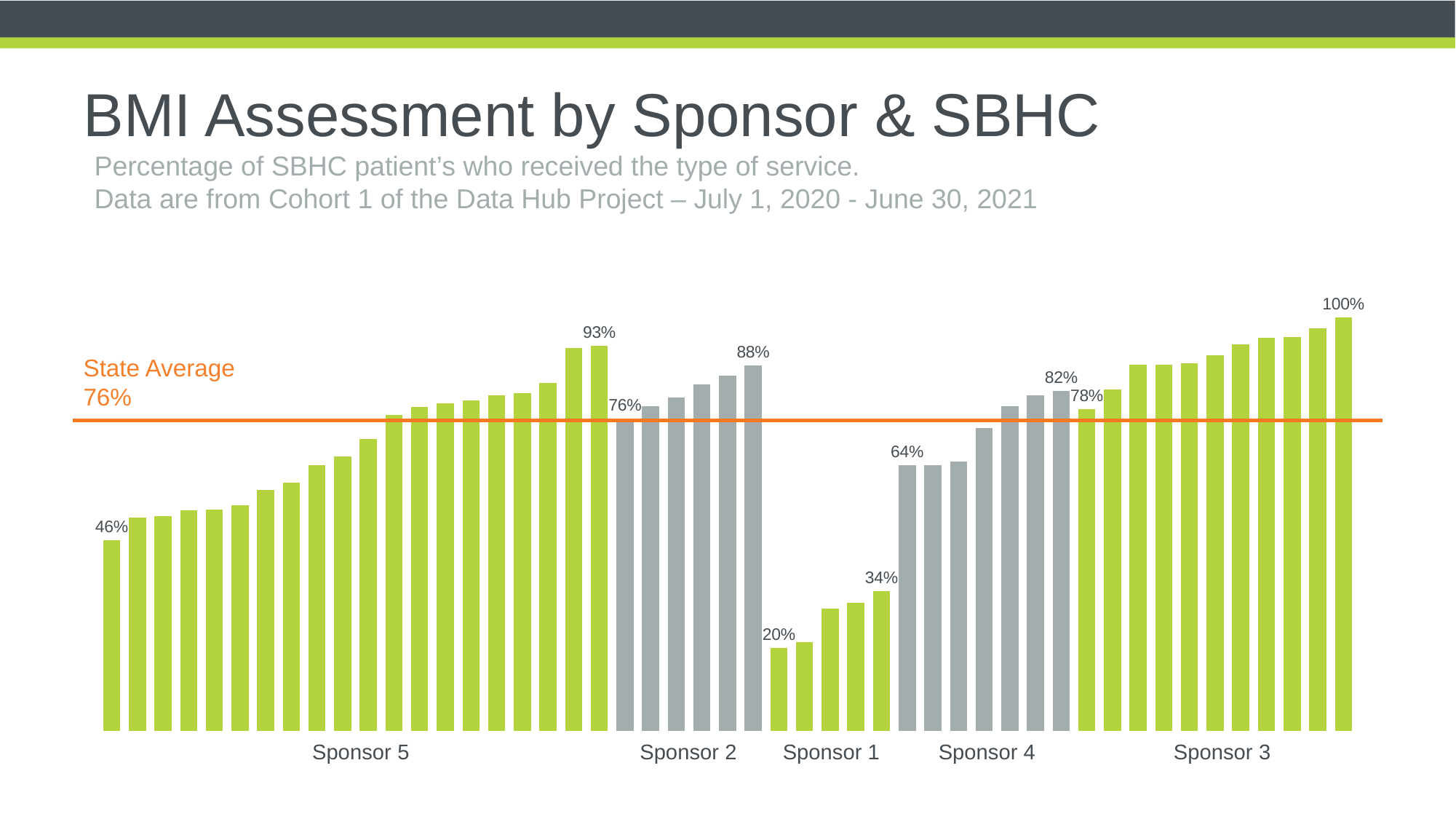
Which sponsor has the bar with the lowest value on the chart? Sponsor 1 What is the difference between the highest labelled value for Sponsor 2 (88%) and its lowest (76%)? 12 percentage points What is the State Average value marked on the chart? 76% What kind of chart is shown on the slide? Bar chart What is the lowest value shown for Sponsor 1? 20% Which sponsor has the bar with the highest value on the chart? Sponsor 3 Is the highest value for Sponsor 4 greater or less than the 76% state average? greater Which is larger: the highest value for Sponsor 5 or the highest value for Sponsor 2? Sponsor 5 How many sponsors are shown on the x axis? 5 What is the highest value labelled for Sponsor 5? 93% What is the difference between the highest (93%) and lowest (46%) labelled values for Sponsor 5? 47 percentage points What is the highest value shown for Sponsor 3? 100%